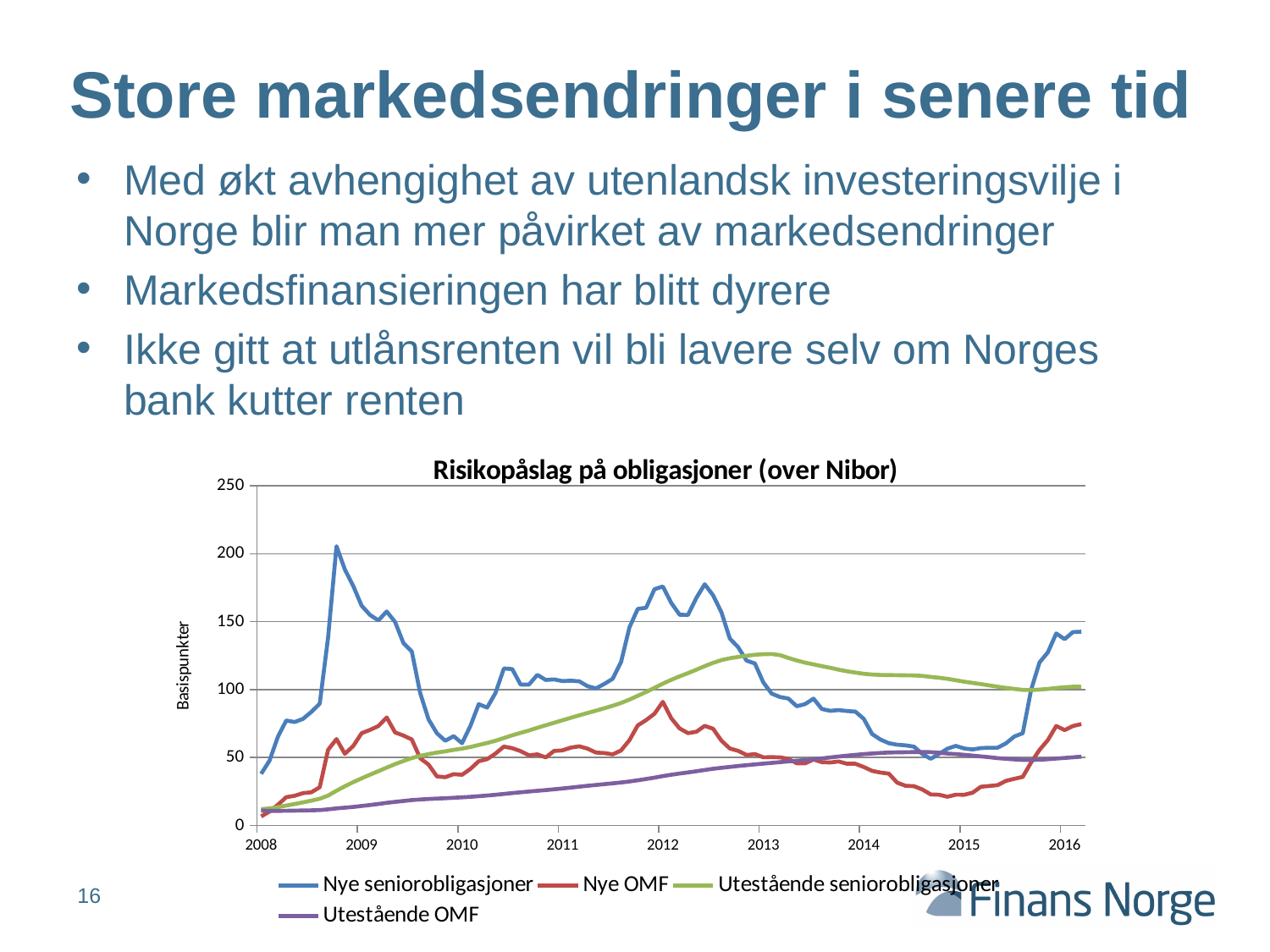
How many series does the legend of the chart list? 4 Does the Utestående OMF series generally rise or fall from 2008 to 2016? Rise Is the peak value of Nye seniorobligasjoner in late 2008 greater or less than 150? greater Which series reaches the highest value anywhere on the chart? Nye seniorobligasjoner Which series has the lowest value at the start of 2012? Utestående OMF Is the value for Nye OMF at the start of 2015 greater or less than 50? less Is the value for Utestående OMF at the start of 2008 greater or less than 50? less What is the label of the vertical axis of the chart? Basispunkter What kind of chart is shown on the slide? Line chart At the start of 2016, which series has the higher value: Nye seniorobligasjoner or Nye OMF? Nye seniorobligasjoner What is the title of the chart? Risikopåslag på obligasjoner (over Nibor)